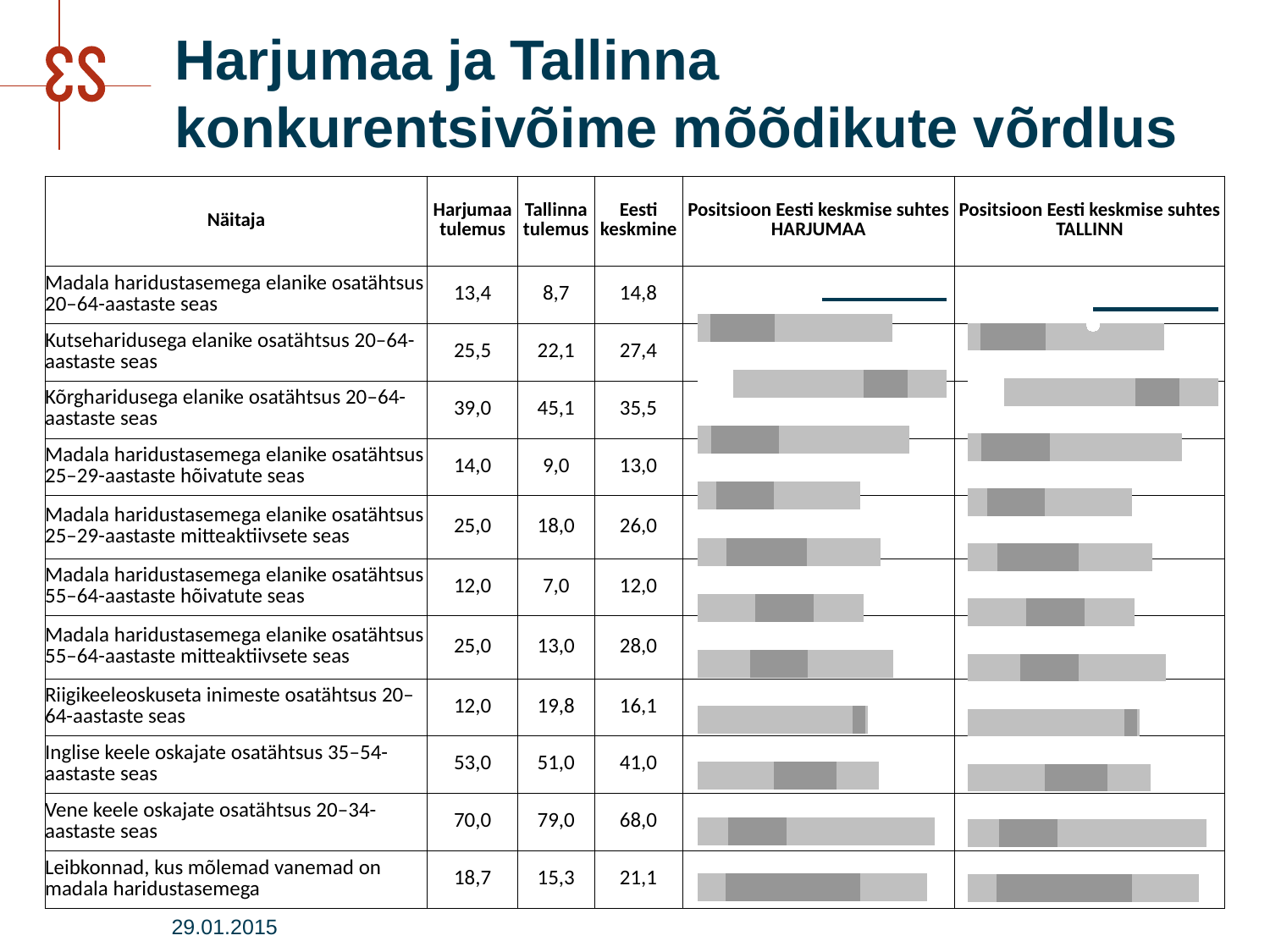
Which indicator has the highest Tallinn result? Vene keele oskajate osatähtsus 20–34-aastaste seas For 'Madala haridustasemega elanike osatähtsus 55–64-aastaste mitteaktiivsete seas', which is larger: the Tallinn result or the Estonian average? Estonian average What is the Harjumaa result (Harjumaa tulemus) for 'Kõrgharidusega elanike osatähtsus 20–64-aastaste seas'? 39,0 How many indicators (rows) are compared on the slide? 11 For 'Inglise keele oskajate osatähtsus 35–54-aastaste seas', which is larger: the Harjumaa result or the Tallinn result? Harjumaa result What is the difference between the Tallinn result and the Harjumaa result for 'Kõrgharidusega elanike osatähtsus 20–64-aastaste seas'? 6,1 What is the Estonian average (Eesti keskmine) for 'Leibkonnad, kus mõlemad vanemad on madala haridustasemega'? 21,1 What is the Tallinn result for 'Riigikeeleoskuseta inimeste osatähtsus 20–64-aastaste seas'? 19,8 Which indicator has the highest Harjumaa result? Vene keele oskajate osatähtsus 20–34-aastaste seas What is the Tallinn result (Tallinna tulemus) for 'Vene keele oskajate osatähtsus 20–34-aastaste seas'? 79,0 What is the title of the slide? Harjumaa ja Tallinna konkurentsivõime mõõdikute võrdlus Which indicator has the lowest Tallinn result? Madala haridustasemega elanike osatähtsus 55–64-aastaste hõivatute seas